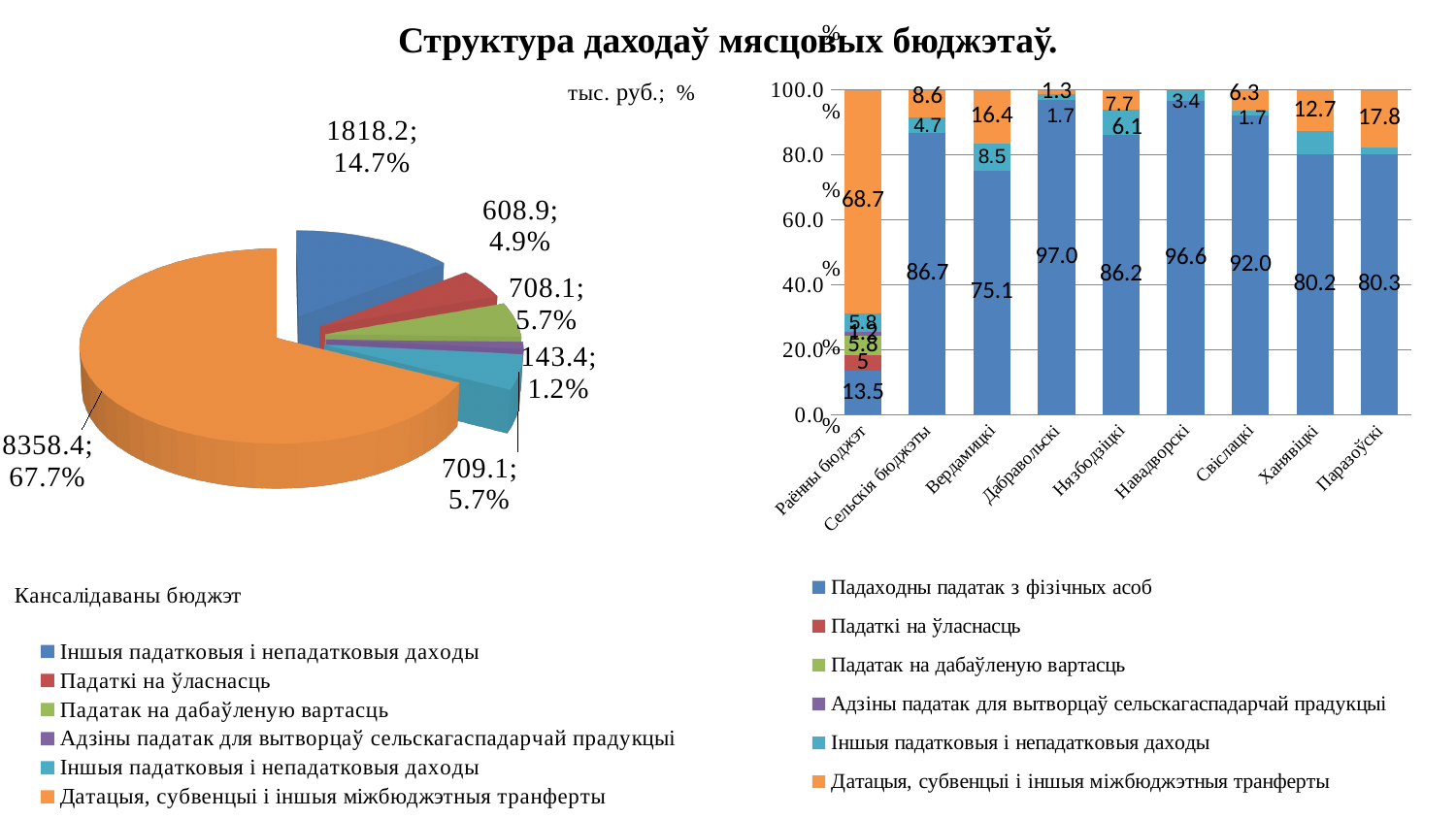
In the bar chart on the right, what is the difference between the Падаходны падатак з фізічных асоб values for Навадворскі and Вердамічкі? 21.5 In the pie chart (Кансалідаваны бюджэт), what share does Датацыі, субвенцыі і іншыя міжбюджэтныя трансферты have? 67.7% In the bar chart on the right, what is the value of Датацыі, субвенцыі і іншыя міжбюджэтныя трансферты for Раённы бюджэт? 68.7 In the pie chart (Кансалідаваны бюджэт), which category has the largest slice? Датацыі, субвенцыі і іншыя міжбюджэтныя трансферты In the bar chart on the right, which category has the highest value for Падаходны падатак з фізічных асоб? Дабравольскі What kind of chart is the chart on the left of the slide? Pie chart In the bar chart on the right, what is the value of Падаходны падатак з фізічных асоб for Дабравольскі? 97.0 In the bar chart on the right, which has the larger value for Датацыі, субвенцыі і іншыя міжбюджэтныя трансферты: Паразоўскі or Ханявіцкі? Паразоўскі In the pie chart (Кансалідаваны бюджэт), what value is shown for Падаткі на ўласнасць? 608.9; 4.9% In the bar chart on the right, how many budget categories are shown on the x axis? 9 In the bar chart on the right, how many series does the legend list? 6 In the pie chart (Кансалідаваны бюджэт), which category has the smallest slice? Адзіны падатак для вытворцаў сельскагаспадарчай прадукцыі